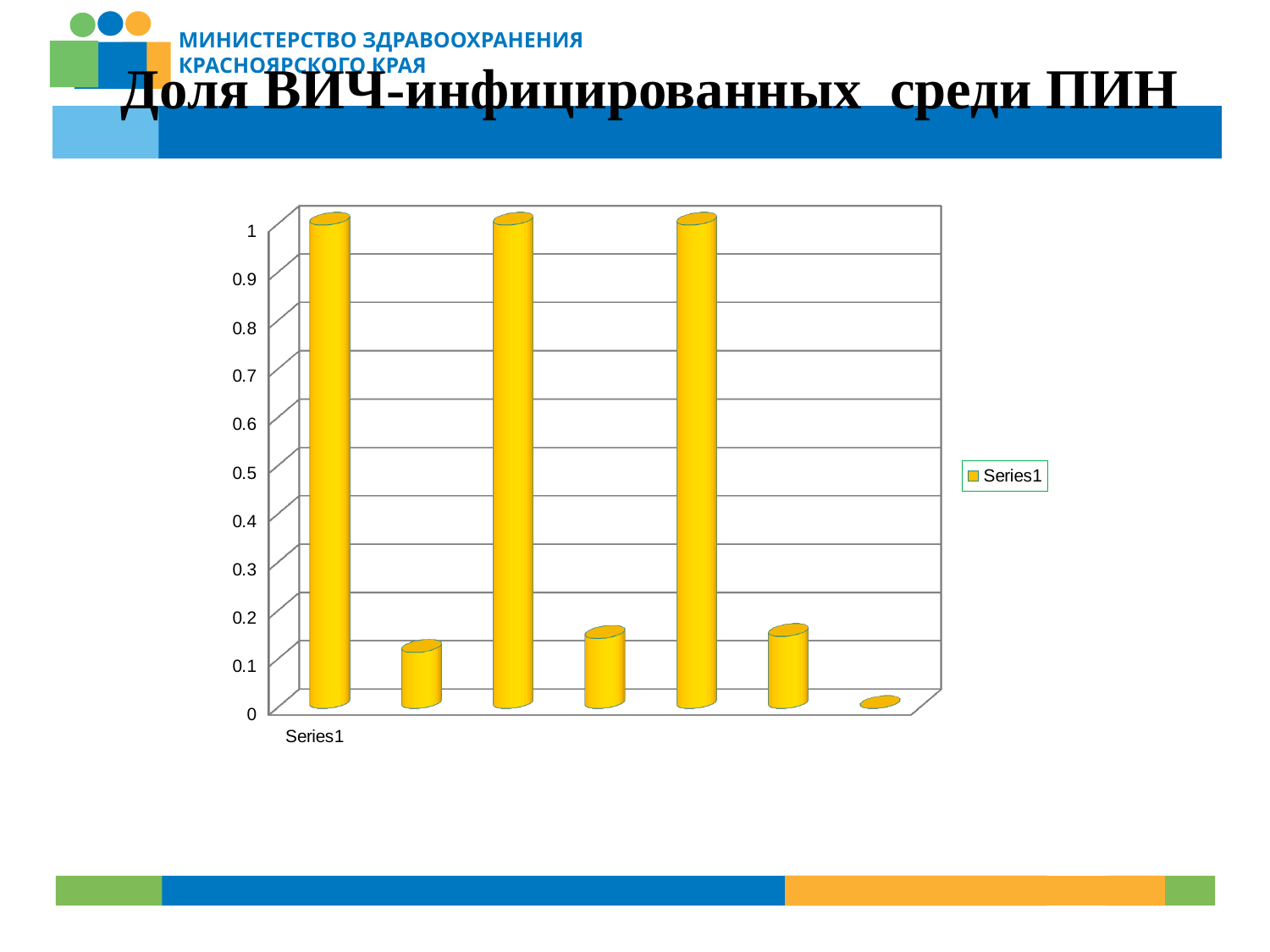
Is the value of the sixth bar from the left greater or less than 0.3? less Which is larger, the first bar from the left or the second bar from the left? the first bar What is the name of the series shown in the legend? Series1 Is the value of the last bar on the right greater or less than 0.1? less What kind of chart is shown on the slide? bar chart What is the title of the slide above the chart? Доля ВИЧ-инфицированных среди ПИН Is the value of the second bar from the left greater or less than 0.5? less How many series does the legend list? 1 Which bar has the lowest value in the chart? the last bar on the right How many bars are plotted in the chart? 7